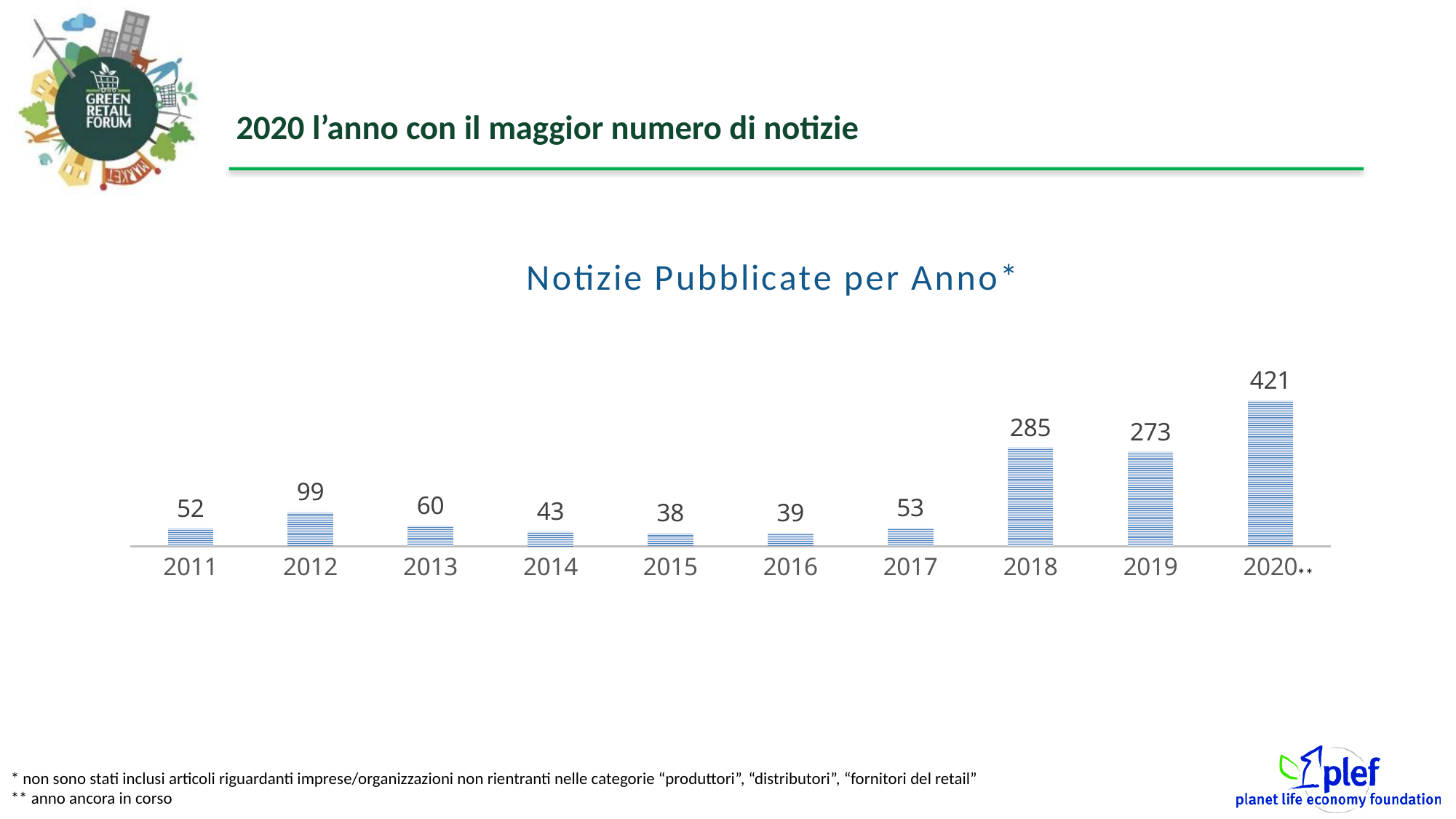
Which is larger, the value for 2013 or the value for 2014? 2013 Which is larger, the value for 2018 or the value for 2019? 2018 What is the difference between the values for 2018 and 2017? 232 What is the value for 2018 in the chart? 285 What is the value for 2015 in the chart? 38 What is the difference between the values for 2020 and 2019? 148 Which year has the lowest value in the chart? 2015 Which year has the highest value in the chart? 2020 What is the title of the chart? Notizie Pubblicate per Anno* What is the value for 2012 in the chart? 99 What kind of chart is shown on the slide? Bar chart How many years are shown in the chart? 10